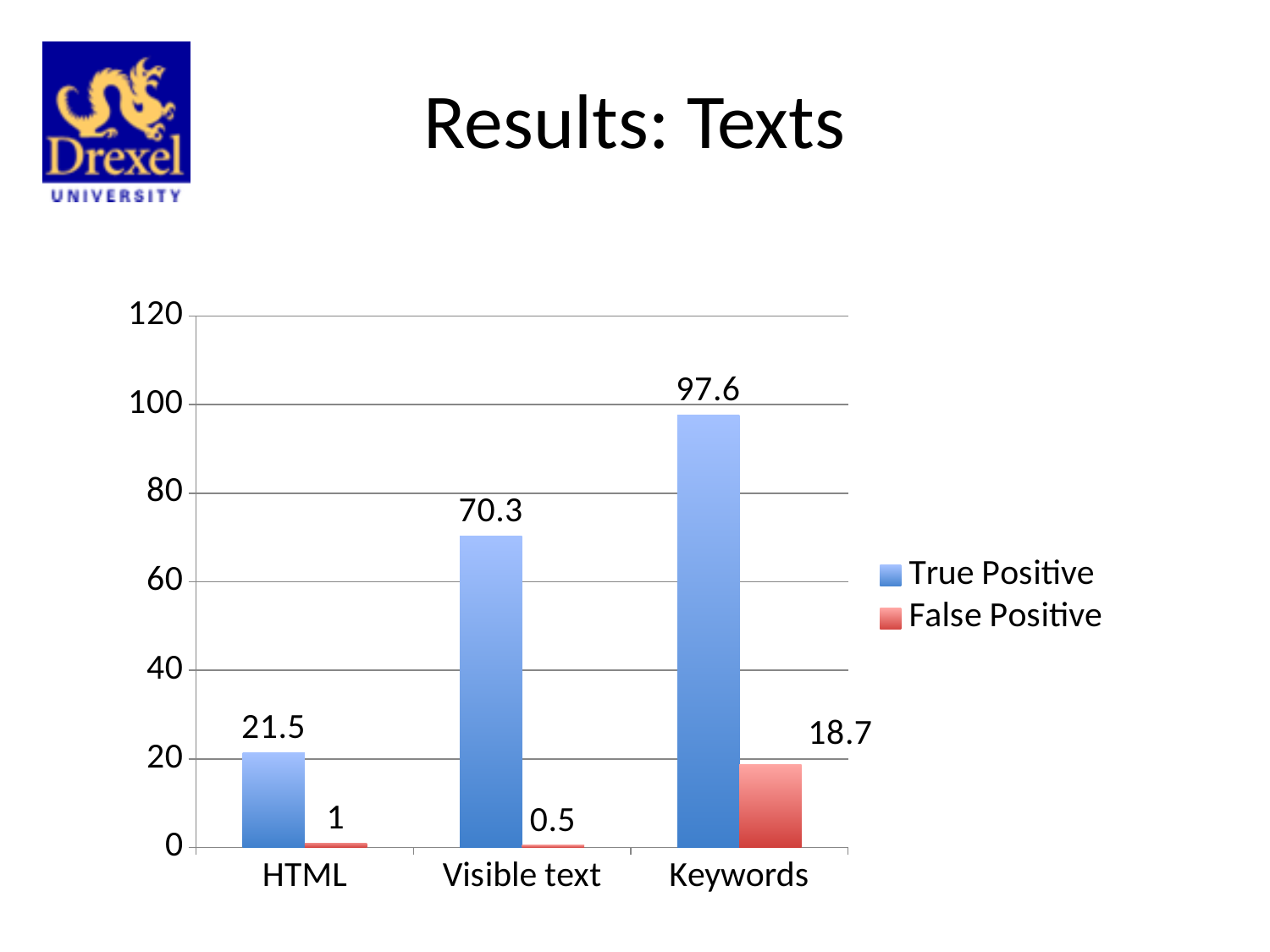
What is the True Positive value for Keywords? 97.6 How many categories are shown on the x axis? 3 Which category has the highest True Positive value? Keywords What is the difference between the True Positive values for Keywords and Visible text? 27.3 Is the True Positive value for Visible text greater or less than 60? greater What is the False Positive value for Keywords? 18.7 What is the False Positive value for HTML? 1 Which category has the lowest False Positive value? Visible text How many series does the legend list? 2 Which is larger, the True Positive value for HTML or the False Positive value for Keywords? True Positive value for HTML What kind of chart is shown on the slide? Bar chart What is the True Positive value for Visible text? 70.3